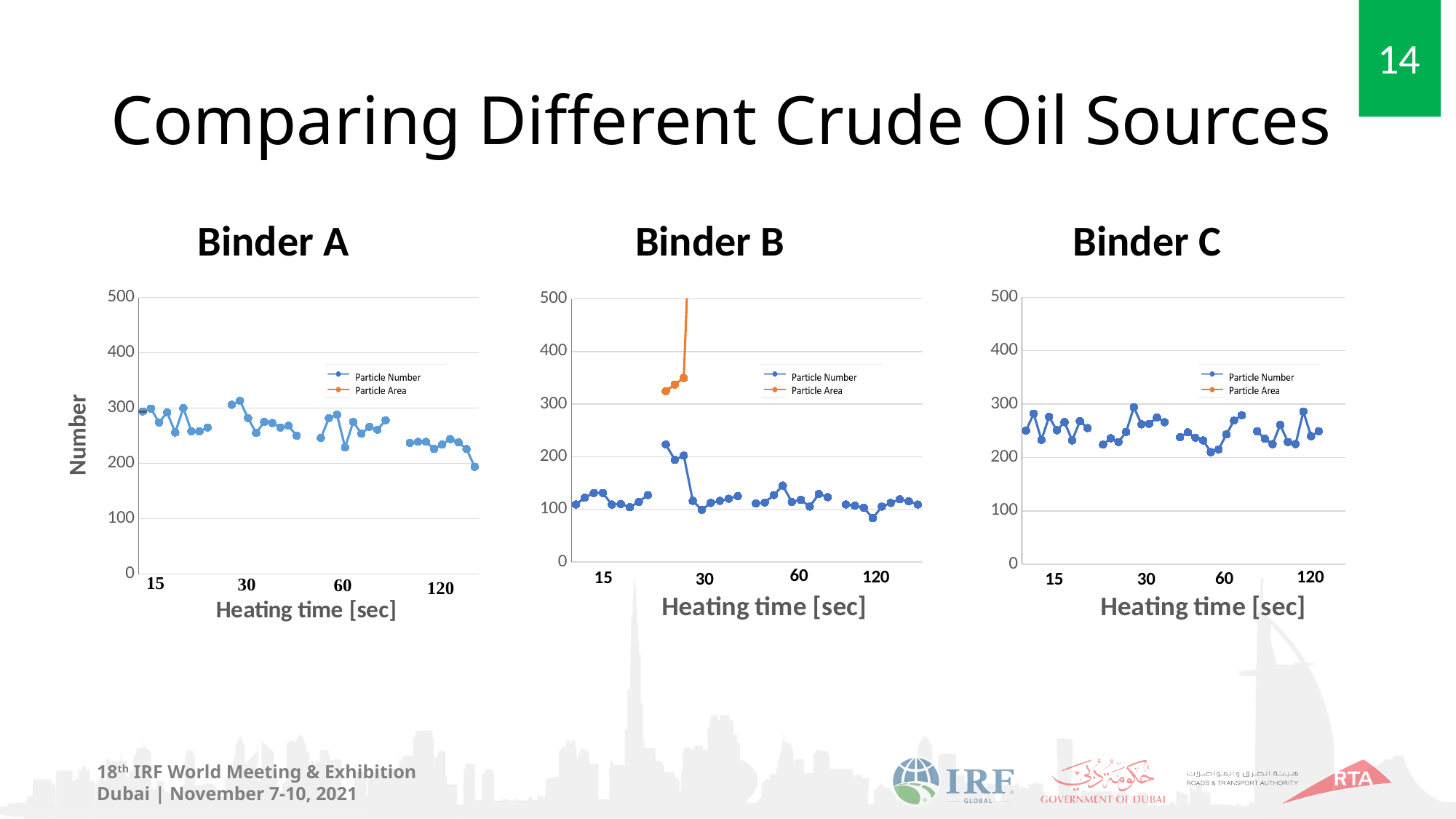
Which chart shows lower Particle Number values overall, Binder A or Binder B? Binder B What is the x-axis label on the Binder A chart? Heating time [sec] In the Binder A chart, are the Particle Number values at the 120 sec heating time greater or less than 300? less In the Binder B chart, are the Particle Area values near 30 sec greater or less than 300? greater In the Binder A chart, do the Particle Number values generally rise or fall as heating time increases from 15 to 120 sec? fall How many series does the legend of the Binder B chart list? 2 What kind of chart is the Binder A chart? line chart What is the highest value shown on the y axis of the Binder C chart? 500 In the Binder C chart, are the Particle Number values at the 15 sec heating time greater or less than 100? greater In the Binder B chart, does the Particle Area series rise or fall along the x axis? rise What are the two series named in the legend of the Binder C chart? Particle Number and Particle Area